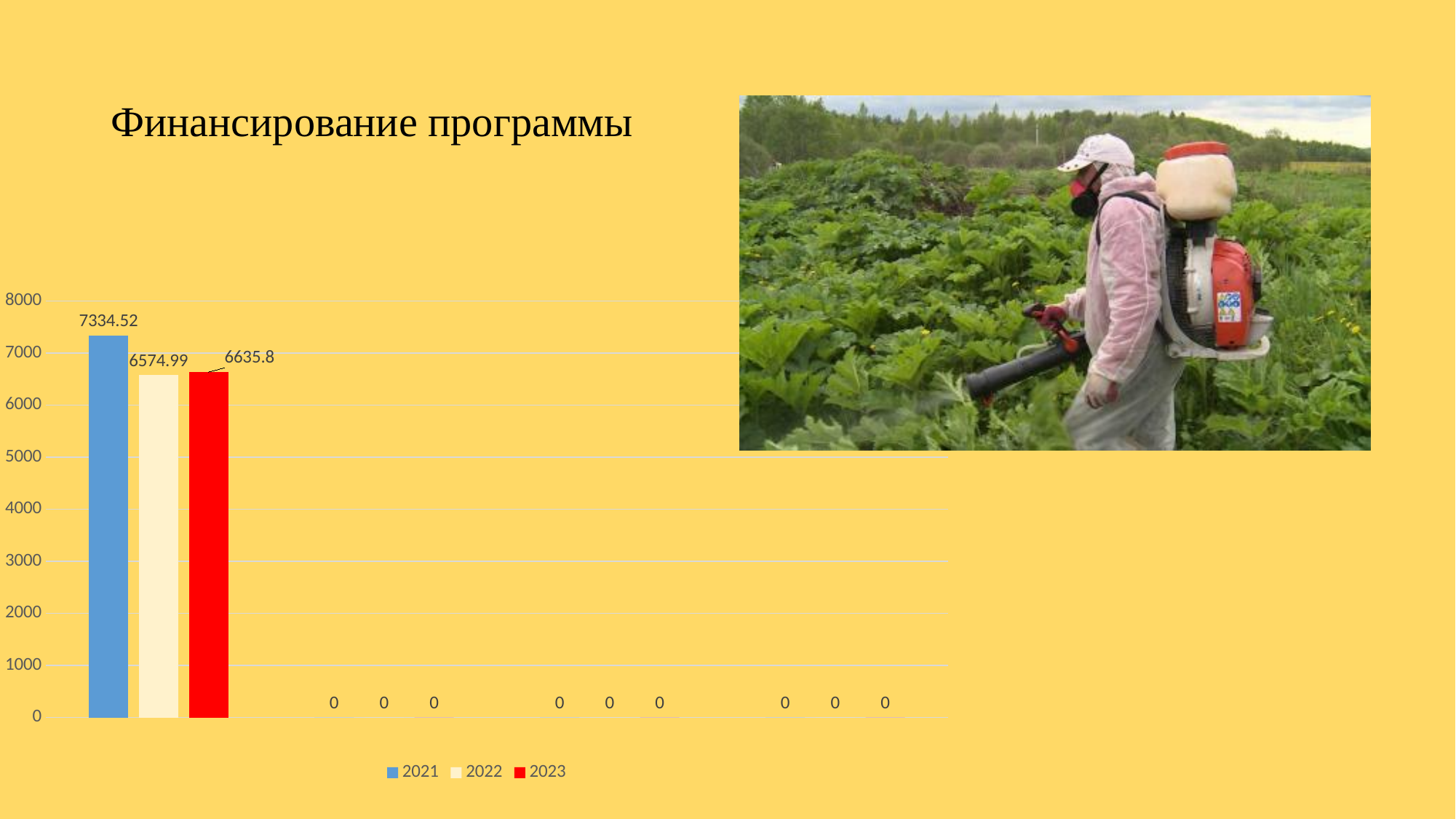
What kind of chart is shown on the slide? bar chart What is the value of the 2021 bar in the leftmost group of bars? 7334.52 What is the title of the chart? Финансирование программы In the leftmost group of bars, what is the difference between the 2021 value and the 2022 value? 759.53 What is the value of the 2022 bar in the leftmost group of bars? 6574.99 Is the value of the 2021 bar in the leftmost group greater or less than 7000? greater How many groups of bars are plotted along the x axis? 4 In the leftmost group of bars, which year has the lowest value? 2022 In the leftmost group of bars, which year has the highest value? 2021 What is the value of the 2023 bar in the leftmost group of bars? 6635.8 How many series does the legend list? 3 In the leftmost group of bars, which is larger: the 2022 value or the 2023 value? 2023